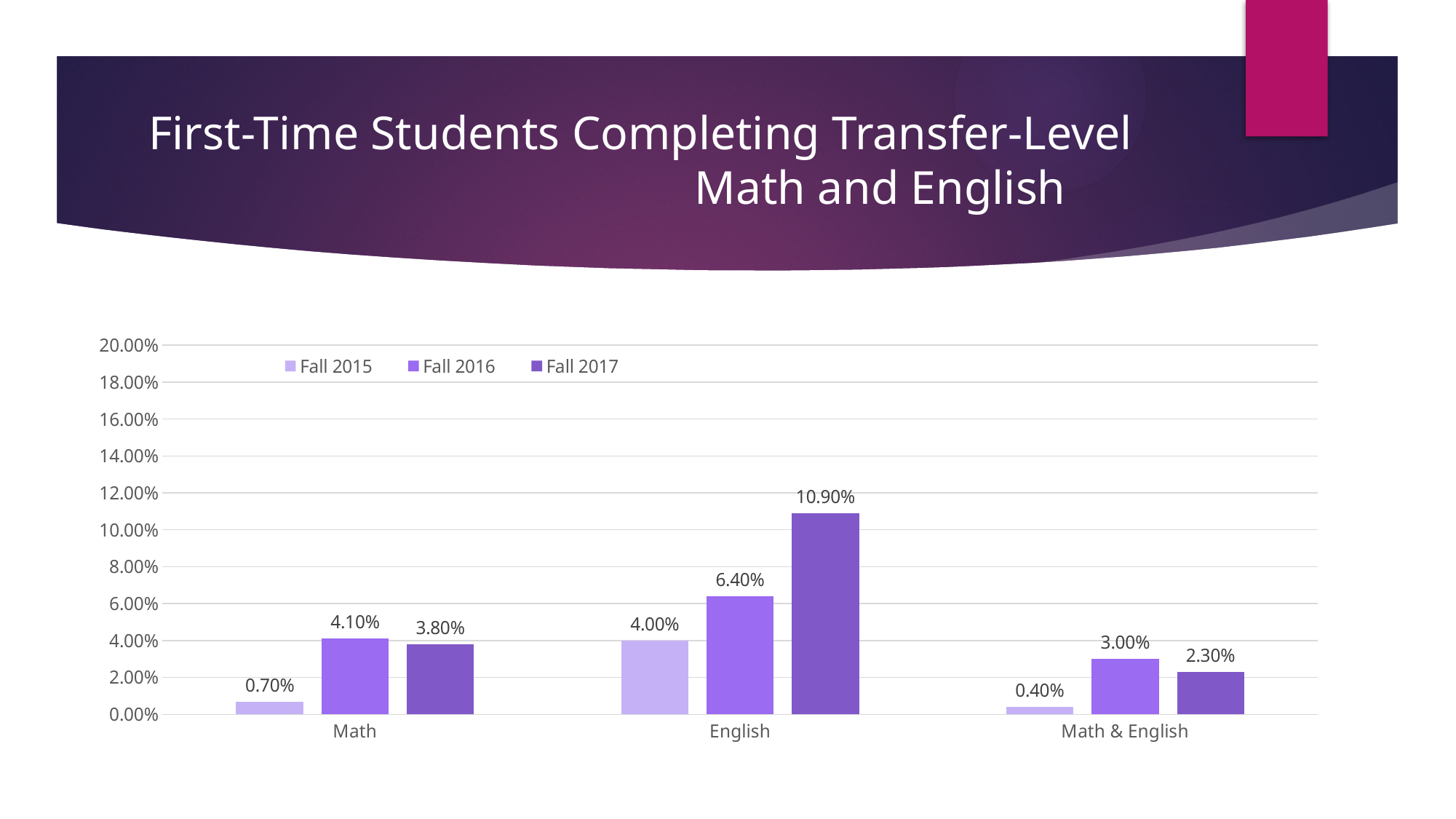
What is the difference between the Fall 2017 and Fall 2016 values for English? 4.50% What is the Fall 2016 value for Math & English? 3.00% What is the Fall 2015 value for Math? 0.70% What is the title of the slide? First-Time Students Completing Transfer-Level Math and English Is the Fall 2017 value for English greater or less than 10.00%? greater How many categories are shown on the x axis? 3 Which category has the highest Fall 2017 value? English How many series does the legend list? 3 Which is larger for Math: the Fall 2016 value or the Fall 2017 value? Fall 2016 What kind of chart is shown on the slide? Bar chart What is the Fall 2017 value for English? 10.90% Which category has the lowest Fall 2015 value? Math & English